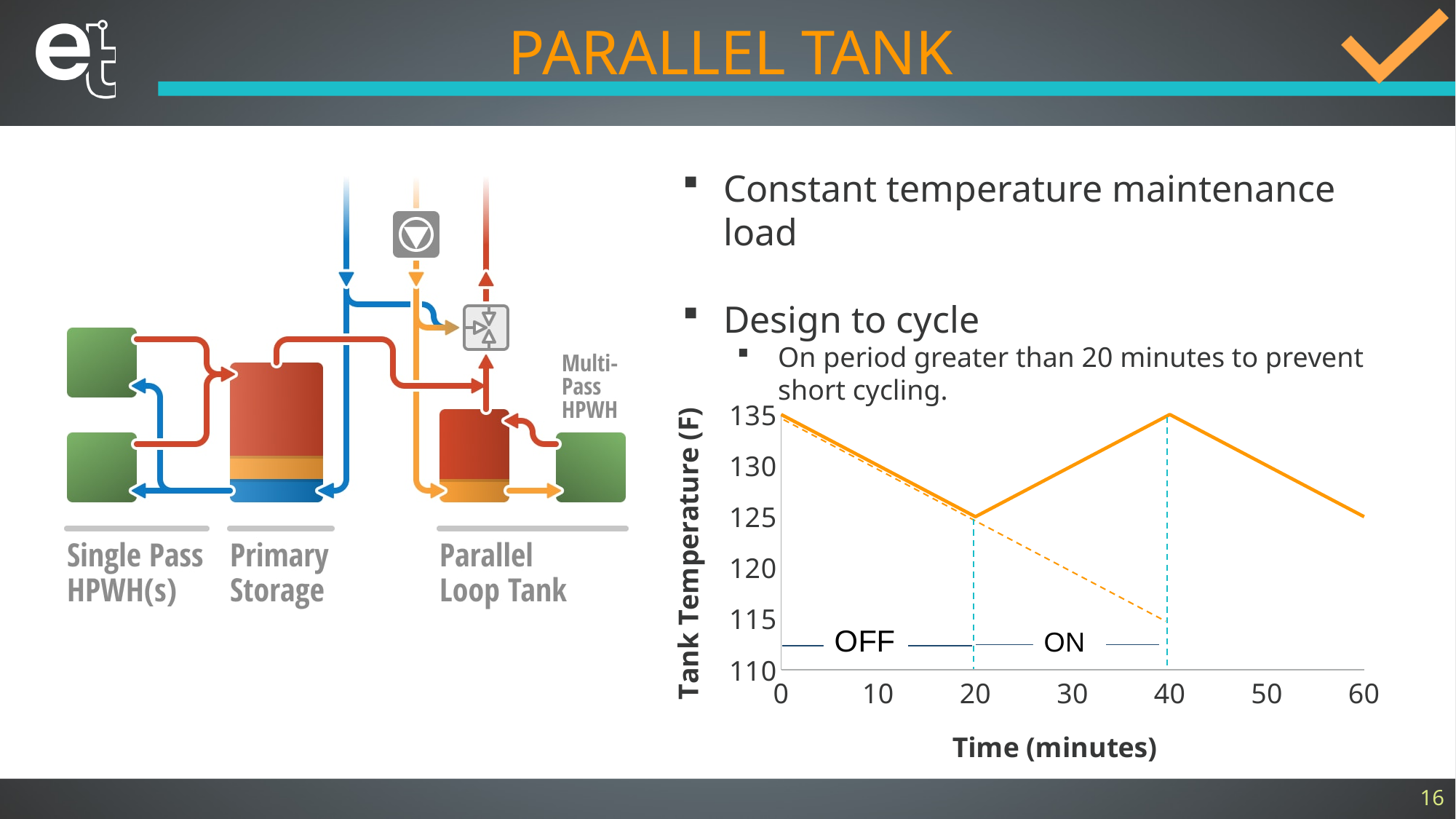
What is the tank temperature of the solid line at 20 minutes? 125 What is the tank temperature of the dashed line at 40 minutes? 115 What is the tank temperature of the solid line at 40 minutes? 135 What is the difference between the solid line's tank temperature at 0 minutes and at 20 minutes? 10 What kind of chart is shown on the slide? line chart What is the label of the y axis of the chart? Tank Temperature (F) Which is larger at 40 minutes: the solid line's tank temperature or the dashed line's tank temperature? the solid line What is the tank temperature of the solid line at 0 minutes? 135 What is the label of the x axis of the chart? Time (minutes) Does the solid line rise or fall between 20 and 40 minutes? rise What is the tank temperature of the solid line at 60 minutes? 125 Does the solid line rise or fall between 0 and 20 minutes? fall